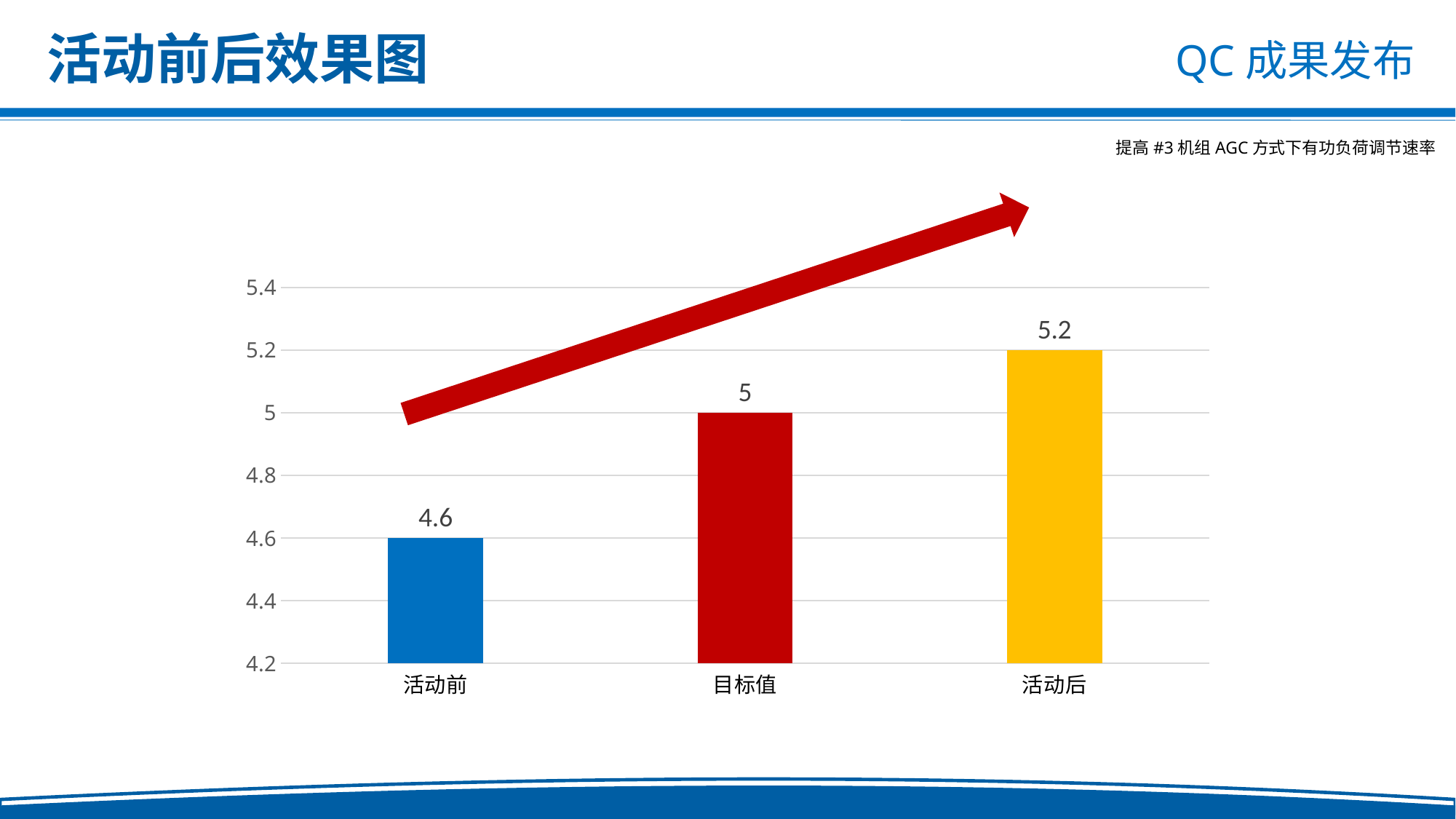
Which category has the lowest value? 活动前 Is the value for 活动后 greater or less than 5? greater What is the difference between the values for 活动后 and 目标值? 0.2 Do the values rise or fall from left to right along the x axis? rise What is the value for 活动前? 4.6 What kind of chart is shown on the slide? bar chart What is the value for 目标值? 5 How many categories are shown on the x axis? 3 What is the value for 活动后? 5.2 Which category has the highest value? 活动后 Which is larger, the value for 目标值 or the value for 活动前? 目标值 What is the difference between the values for 活动后 and 活动前? 0.6